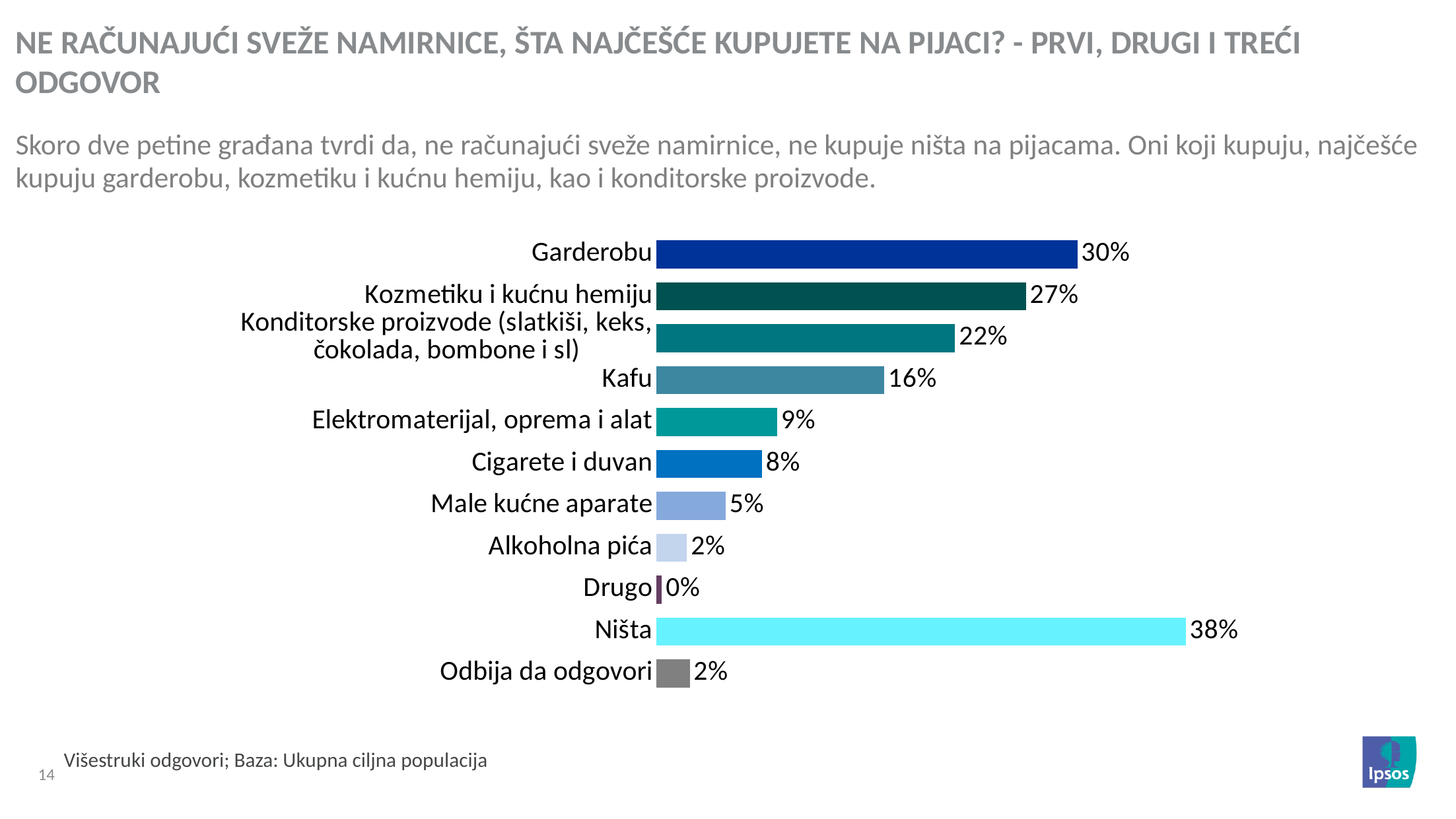
What is the value for Ništa? 38% Which category has the highest value? Ništa What is the difference between the values for Garderobu and Kafu? 14% What is the value for Kozmetiku i kućnu hemiju? 27% How many categories are shown in the chart? 11 What kind of chart is shown on the slide? Bar chart Which is larger, the value for Elektromaterijal, oprema i alat or the value for Cigarete i duvan? Elektromaterijal, oprema i alat What is the value for Kafu? 16% What is the value for Male kućne aparate? 5% What is the value for Garderobu? 30% What is the difference between the values for Ništa and Garderobu? 8% Which category has the lowest value? Drugo